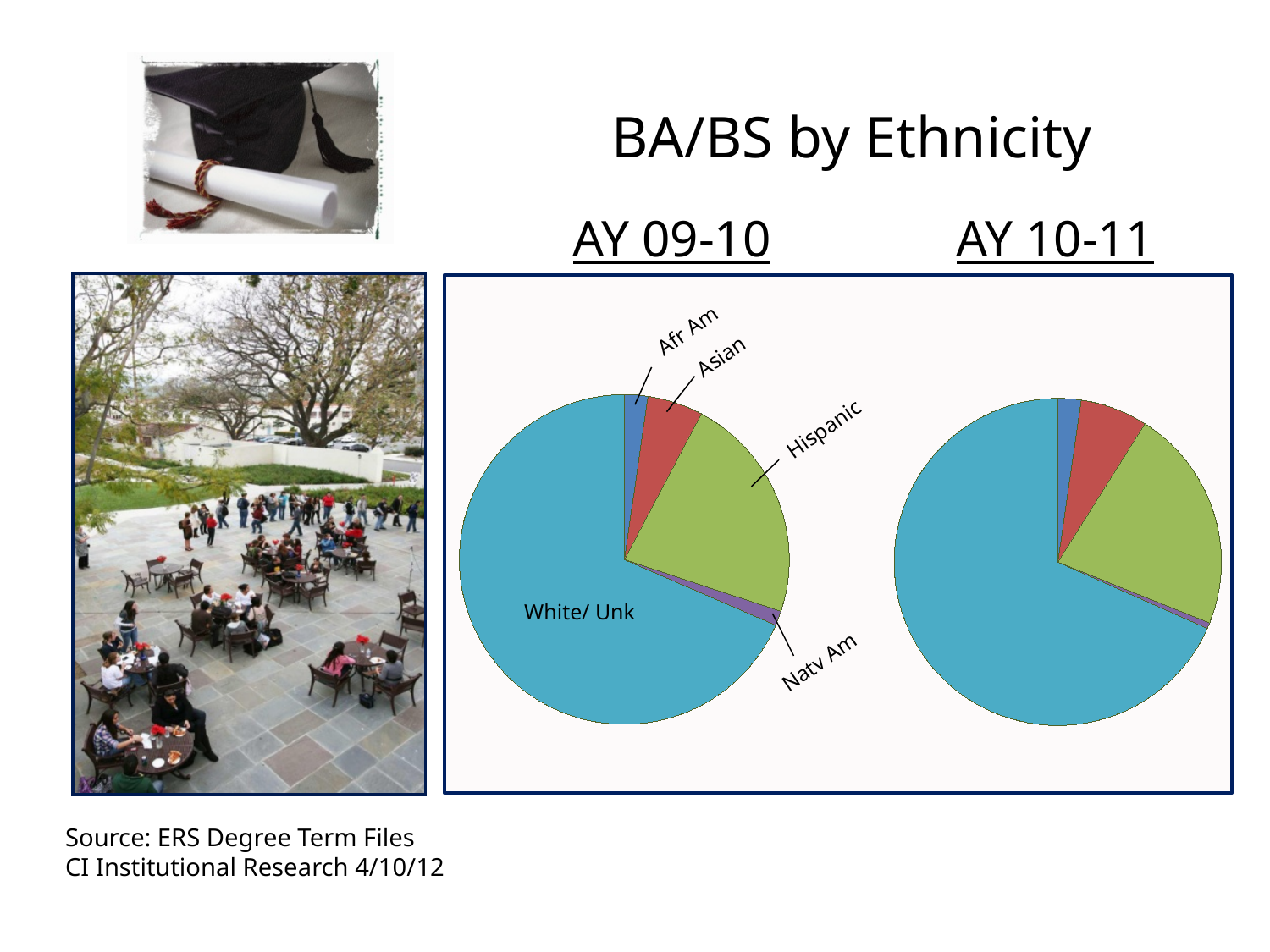
What kind of chart is used for the AY 09-10 data? pie chart In the AY 09-10 pie chart, which ethnicity has the largest slice? White/ Unk In the AY 10-11 pie chart, which ethnicity has the largest slice? White/ Unk In the AY 09-10 pie chart, which ethnicity has the second-largest slice? Hispanic How many ethnicity categories are labelled in the AY 09-10 pie chart? 5 In the AY 09-10 pie chart, which slice is larger, White/ Unk or Hispanic? White/ Unk In the AY 10-11 pie chart, which slice is larger, Hispanic or Asian? Hispanic In the AY 09-10 pie chart, which slice is larger, Hispanic or Asian? Hispanic What is the title of the slide containing the two pie charts? BA/BS by Ethnicity Which academic year does the pie chart on the right represent? AY 10-11